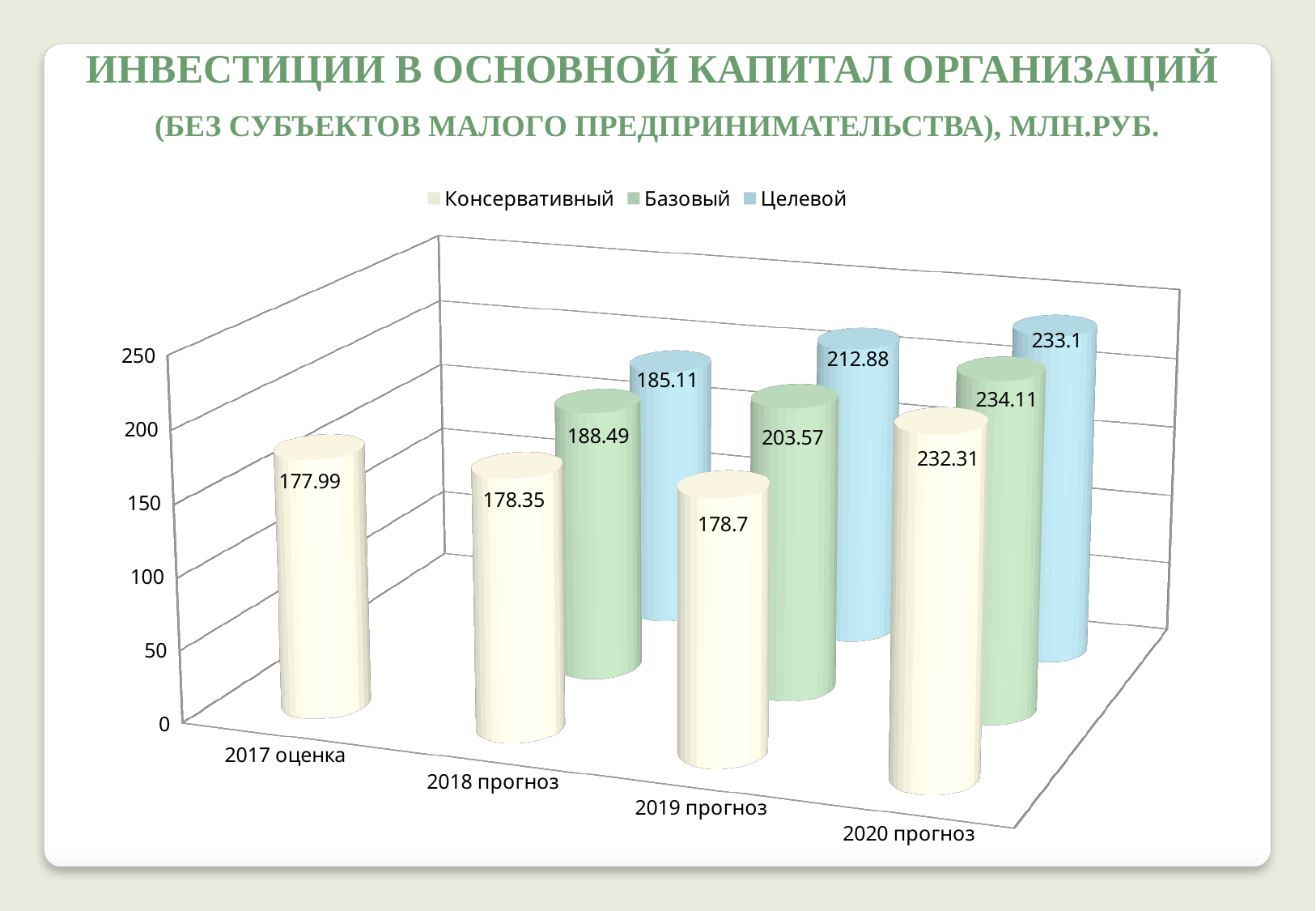
How many categories are shown on the x axis? 4 What is the value for Консервативный in 2017 оценка? 177.99 What is the value for Консервативный in 2019 прогноз? 178.7 What is the value for Целевой in 2019 прогноз? 212.88 Do the values for the Консервативный series rise or fall from 2017 оценка to 2020 прогноз? Rise Which is larger in 2018 прогноз, Базовый or Целевой? Базовый How many series does the legend list? 3 In which category is the Целевой series highest? 2020 прогноз What is the difference between Целевой and Базовый in 2019 прогноз? 9.31 What is the value for Базовый in 2020 прогноз? 234.11 What kind of chart is shown on the slide? Bar chart In which category is the Консервативный series lowest? 2017 оценка